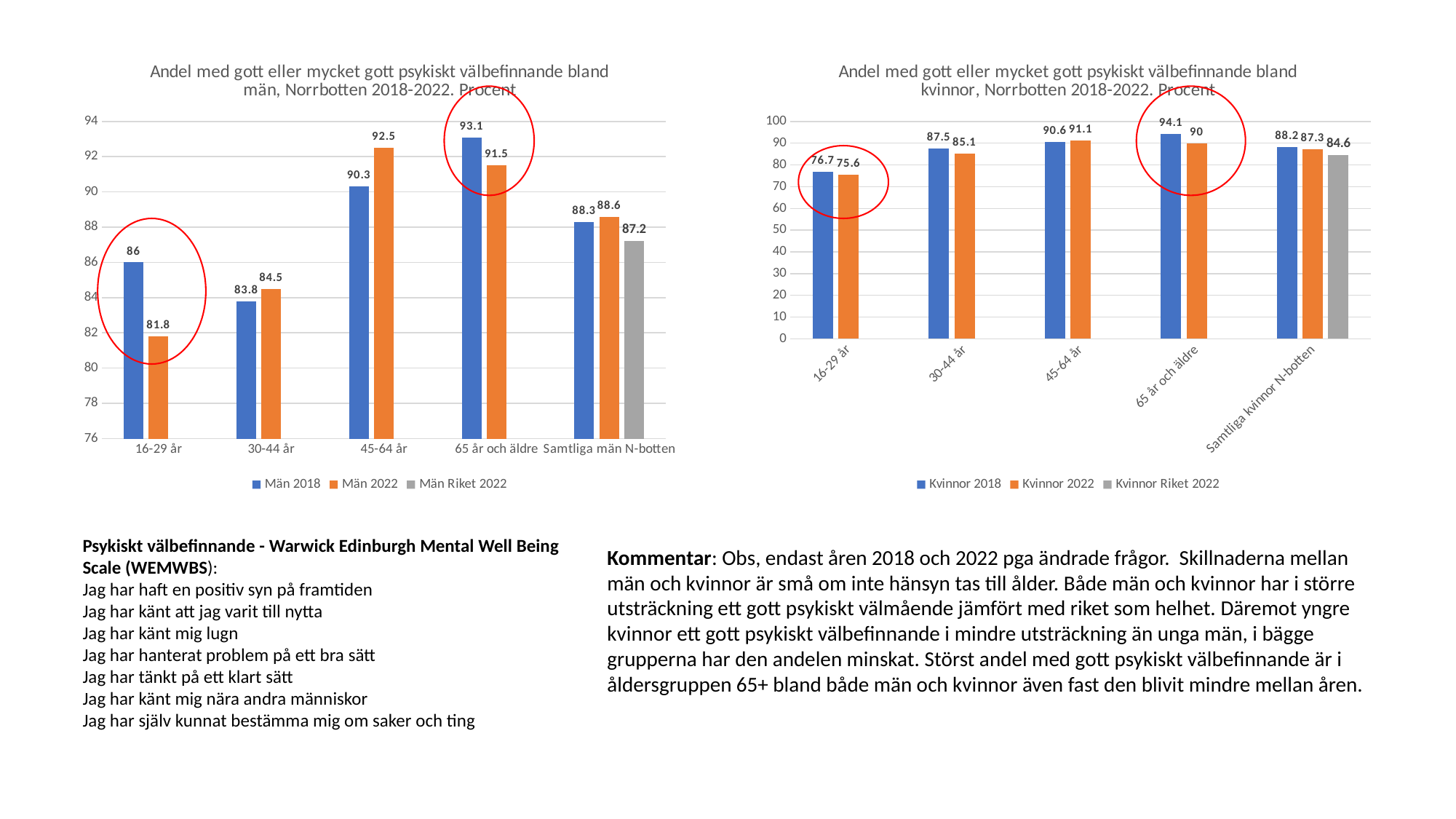
In the right chart (women, Norrbotten), which age group has the highest value for Kvinnor 2022? 45-64 år In the right chart (women, Norrbotten), what is the value for Kvinnor 2018 in the 65 år och äldre group? 94.1 In the left chart (men, Norrbotten), which category has the lowest value for Män 2022? 16-29 år In the left chart (men, Norrbotten), what is the value for Män 2022 in the 16-29 år group? 81.8 In the left chart (men, Norrbotten), what is the difference between Män 2018 and Män 2022 for the 16-29 år group? 4.2 In the right chart (women, Norrbotten), which is larger for the 30-44 år group: Kvinnor 2018 or Kvinnor 2022? Kvinnor 2018 What kind of chart is the right chart (women, Norrbotten)? Bar chart In the left chart (men, Norrbotten), what is the value for Män Riket 2022? 87.2 How many categories are shown on the x axis of the left chart (men, Norrbotten)? 5 In the left chart (men, Norrbotten), is the value for Män 2018 in the 45-64 år group greater or less than 90? greater How many series does the legend of the right chart (women, Norrbotten) list? 3 In the right chart (women, Norrbotten), what is the difference between Kvinnor 2018 and Kvinnor 2022 for the 65 år och äldre group? 4.1